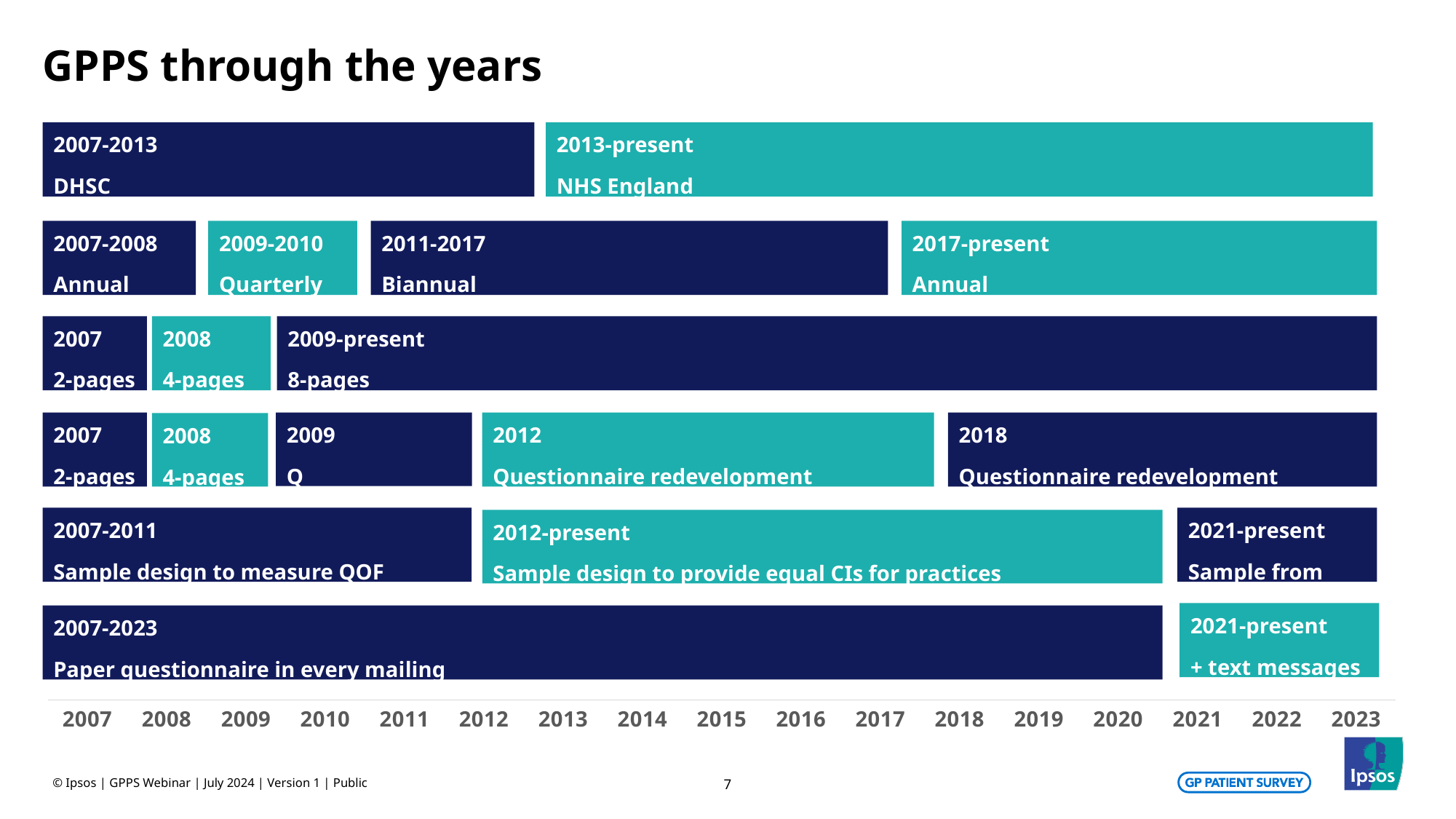
How many rows of timeline bars are shown on the chart? 6 How many year labels are shown along the x axis? 17 From which year has the sample design provided equal CIs for practices? 2012 During which years was the survey run quarterly? 2009-2010 From which year has NHS England been shown as running the survey? 2013 How many pages has the questionnaire had from 2009 to present? 8-pages During which period was the survey biannual? 2011-2017 Over which period was a paper questionnaire included in every mailing? 2007-2023 Which organisation is shown for the period 2007-2013 in the top row? DHSC From which year were text messages added to the mailing? 2021 In which two years did questionnaire redevelopment take place? 2012 and 2018 What kind of chart is shown on the slide? A timeline (Gantt-style bar chart)